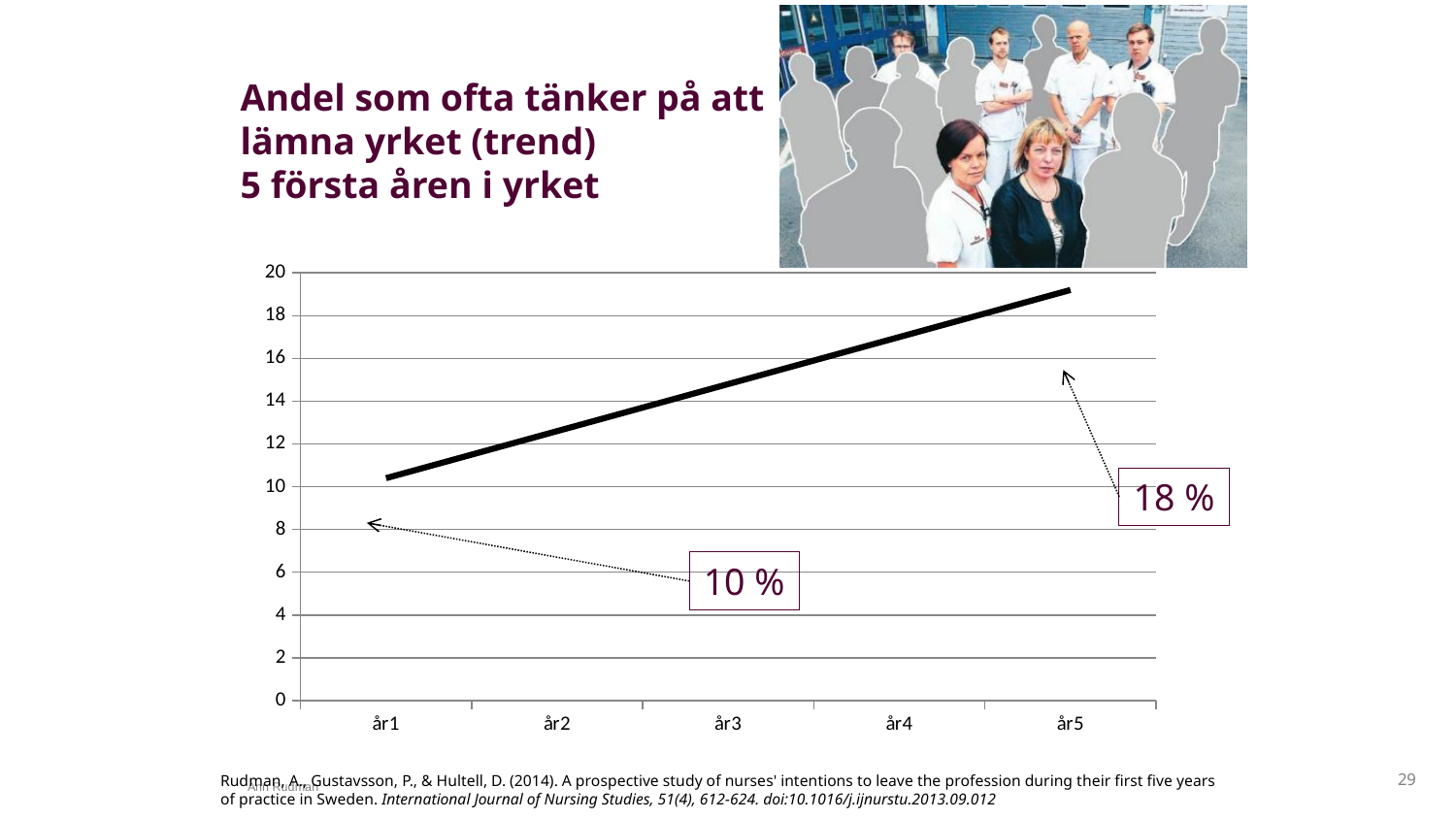
Do the values rise or fall from år1 to år5? rise What text is in the callout box pointing to the år5 end of the line? 18 % Is the value for år1 greater or less than 12? less Which year has the highest value? år5 What kind of chart is shown on the slide? line chart Is the value for år1 greater or less than 8? greater Is the value for år3 greater or less than 12? greater Which year has the lowest value? år1 Which is larger, the value for år1 or the value for år5? år5 What is the title of the chart on the slide? Andel som ofta tänker på att lämna yrket (trend) 5 första åren i yrket How many points (years) are plotted along the x axis? 5